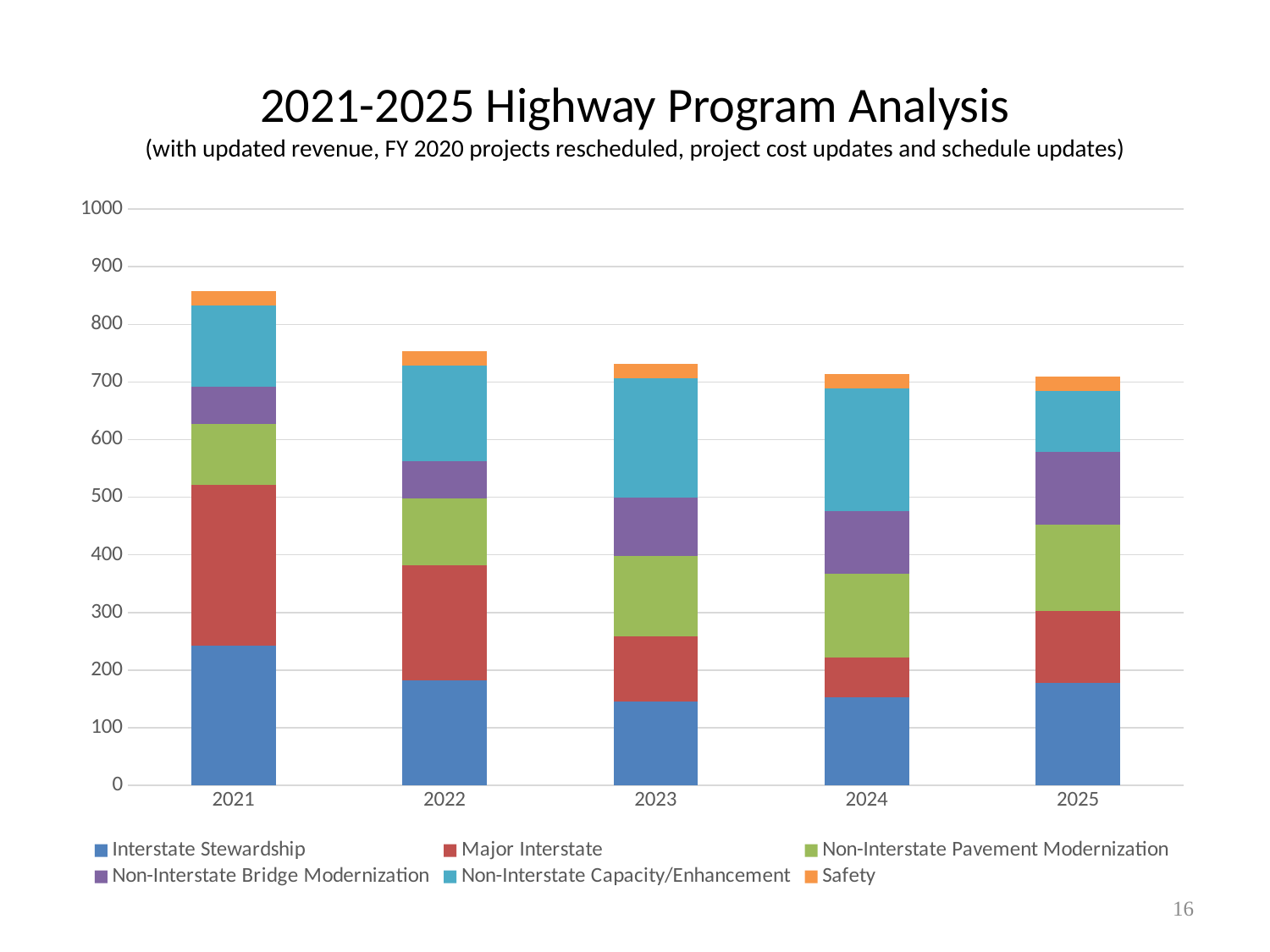
Which series is shown in orange in the legend? Safety Is the Interstate Stewardship value for 2021 greater or less than 200? greater Which series is the smallest segment in every year's bar? Safety Is the Interstate Stewardship value for 2023 greater or less than 200? less Do the total bar heights rise or fall from 2021 to 2025? Fall How many years are shown on the x axis of the chart? 5 Which year has the tallest stacked bar? 2021 Is the total for 2021 greater or less than 800? greater Which is larger, the Major Interstate segment in 2021 or in 2025? 2021 How many series does the legend list? 6 What kind of chart is shown on the slide? Stacked bar chart